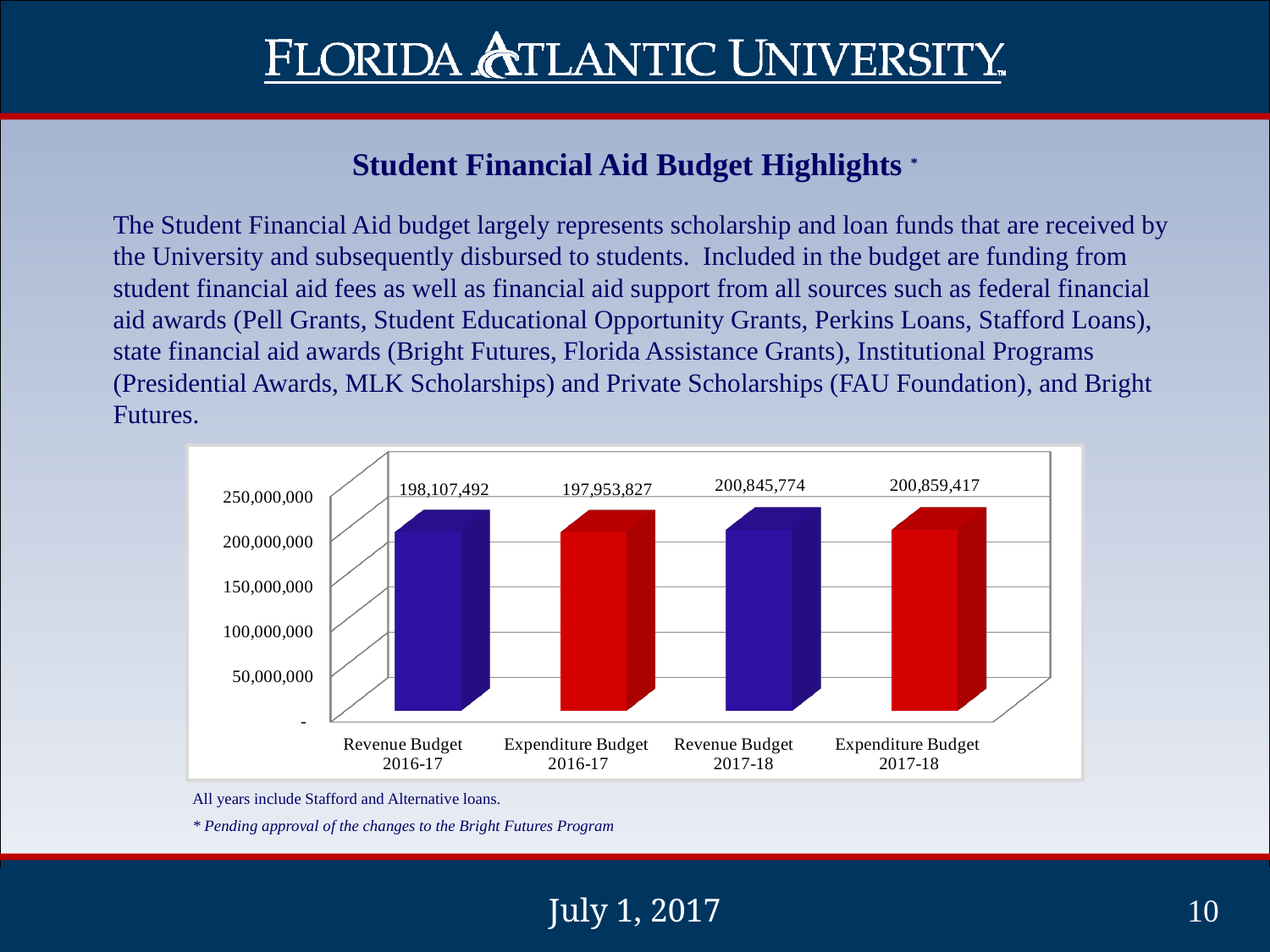
What is the value of the Revenue Budget 2016-17 bar? 198,107,492 How many bars are shown in the chart? 4 What is the difference between the Expenditure Budget 2017-18 and the Expenditure Budget 2016-17? 2,905,590 What is the value of the Expenditure Budget 2017-18 bar? 200,859,417 What is the value of the Revenue Budget 2017-18 bar? 200,845,774 Which category has the lowest value in the chart? Expenditure Budget 2016-17 Which is larger, the Revenue Budget 2017-18 or the Revenue Budget 2016-17? Revenue Budget 2017-18 Which category has the highest value in the chart? Expenditure Budget 2017-18 What is the difference between the Revenue Budget 2017-18 and the Revenue Budget 2016-17? 2,738,282 Is the value for Expenditure Budget 2016-17 greater or less than 150,000,000? greater What is the value of the Expenditure Budget 2016-17 bar? 197,953,827 What kind of chart is shown on the slide? bar chart